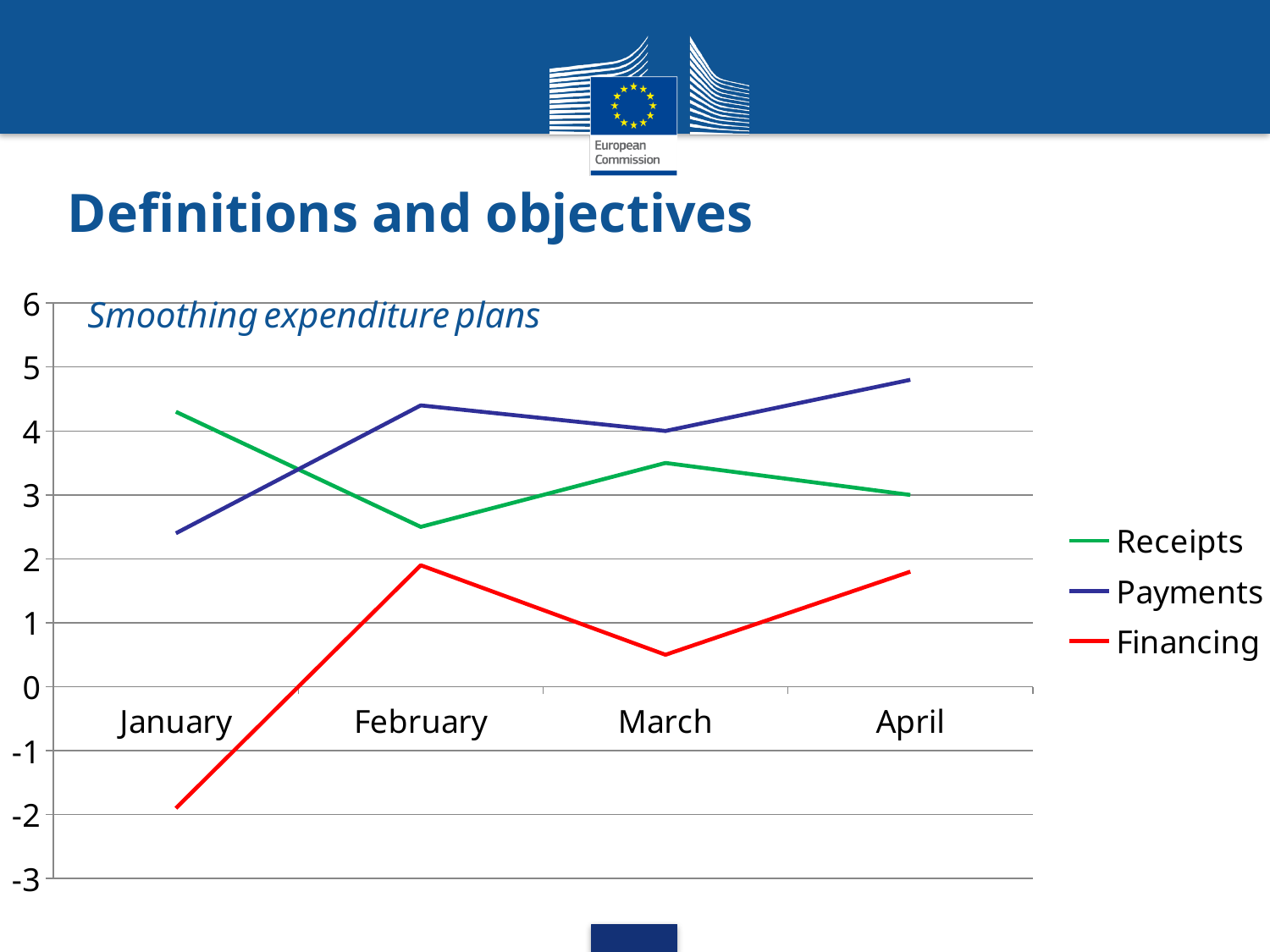
How many months are shown on the x axis? 4 In which month is Receipts lowest? February What is the title of the chart? Smoothing expenditure plans Is the value for Financing in January greater or less than 0? less What is the value of Receipts in April? 3 What is the value of Payments in March? 4 Which series is drawn in red? Financing Which is larger in January, Receipts or Payments? Receipts What kind of chart is shown on the slide? line chart In which month is Financing lowest? January In which month is Payments highest? April How many series does the legend list? 3